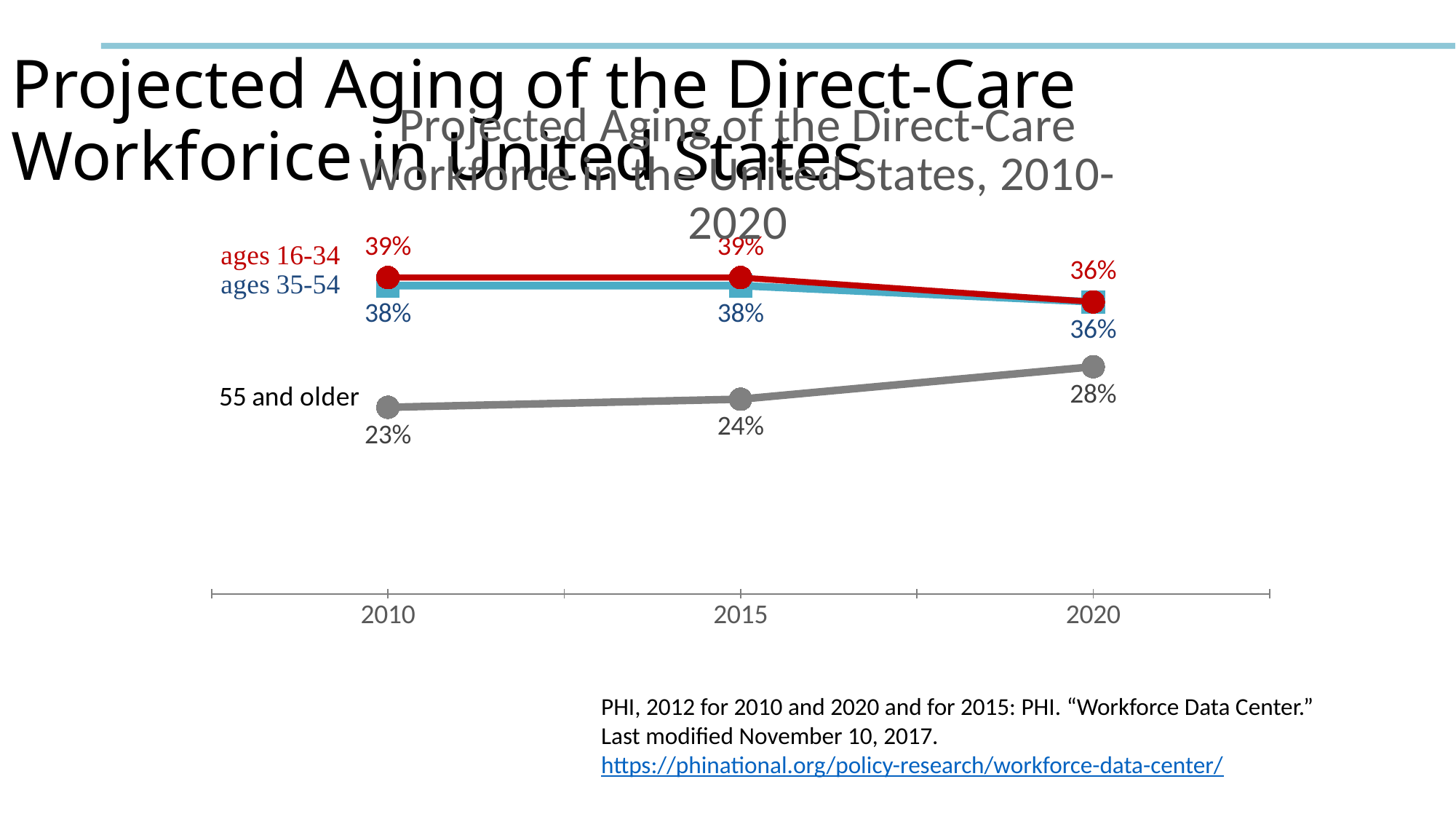
What is the value for 55 and older in 2020? 28% What is the value for ages 35-54 in 2015? 38% Does the 55 and older series rise or fall from 2010 to 2020? rise What is the difference between the 55 and older values in 2020 and 2010? 5% What is the value for ages 16-34 in 2010? 39% What is the value for ages 16-34 in 2020? 36% Which series has the highest value in 2015? ages 16-34 What is the value for 55 and older in 2010? 23% What kind of chart is this? line chart Which is larger in 2015: ages 16-34 or 55 and older? ages 16-34 Which series has the lowest value in 2010? 55 and older How many years are shown on the x axis? 3